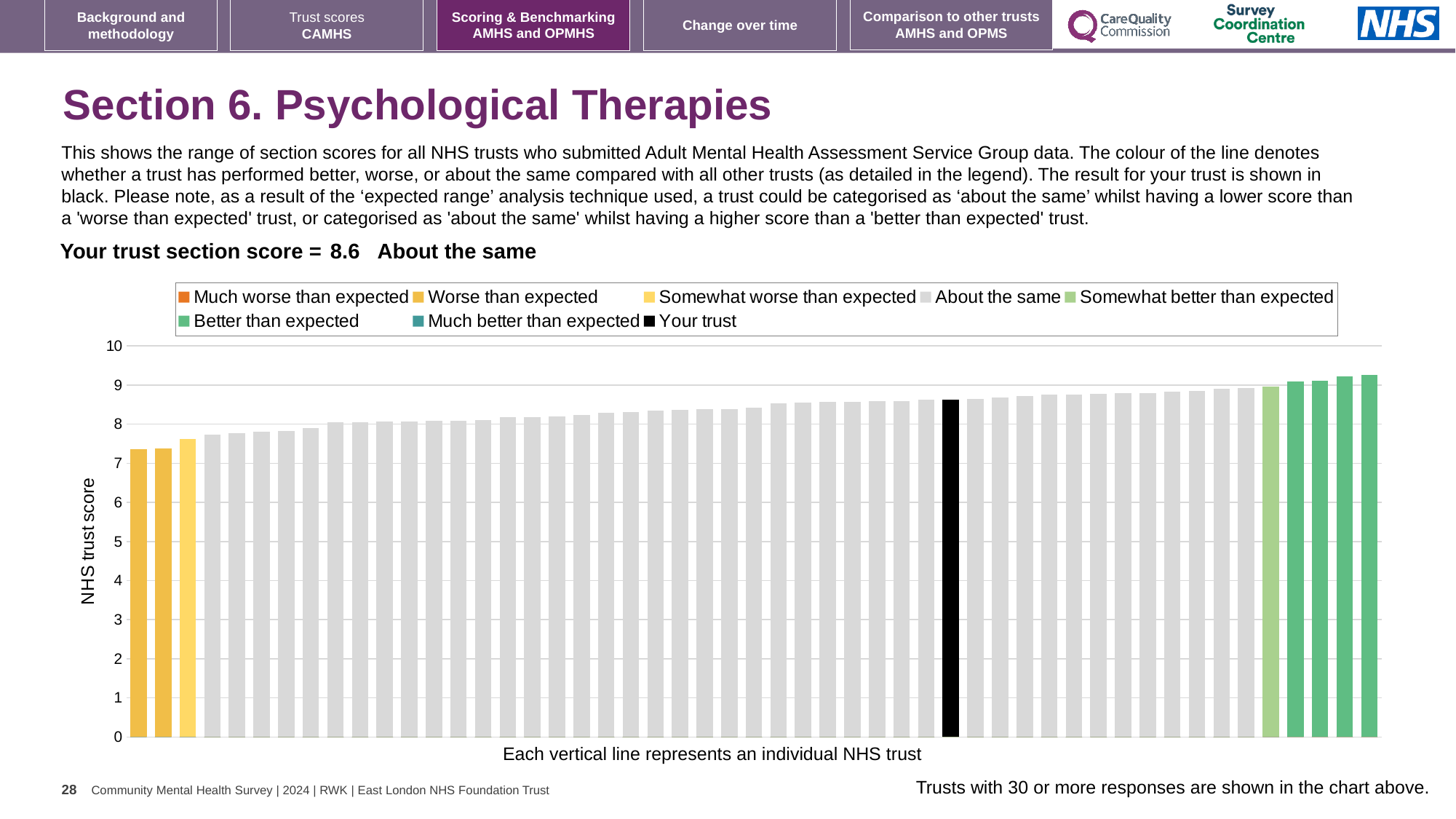
Is the value of the leftmost bar greater or less than 8? less Which is taller, the leftmost bar or the rightmost bar? The rightmost bar What is the section score for your trust shown on the slide? 8.6 Which category is your trust placed in for this section? About the same What colour is the bar representing your trust? Black Is the value of the black 'Your trust' bar greater or less than 8? greater Do the bar values rise or fall from left to right along the x axis? Rise Is the value of the rightmost bar greater or less than 9? greater Which legend category do the tallest bars on the right of the chart belong to? Better than expected What is the label on the y axis of the chart? NHS trust score What kind of chart is shown on the slide? Bar chart How many entries does the chart legend list? 8